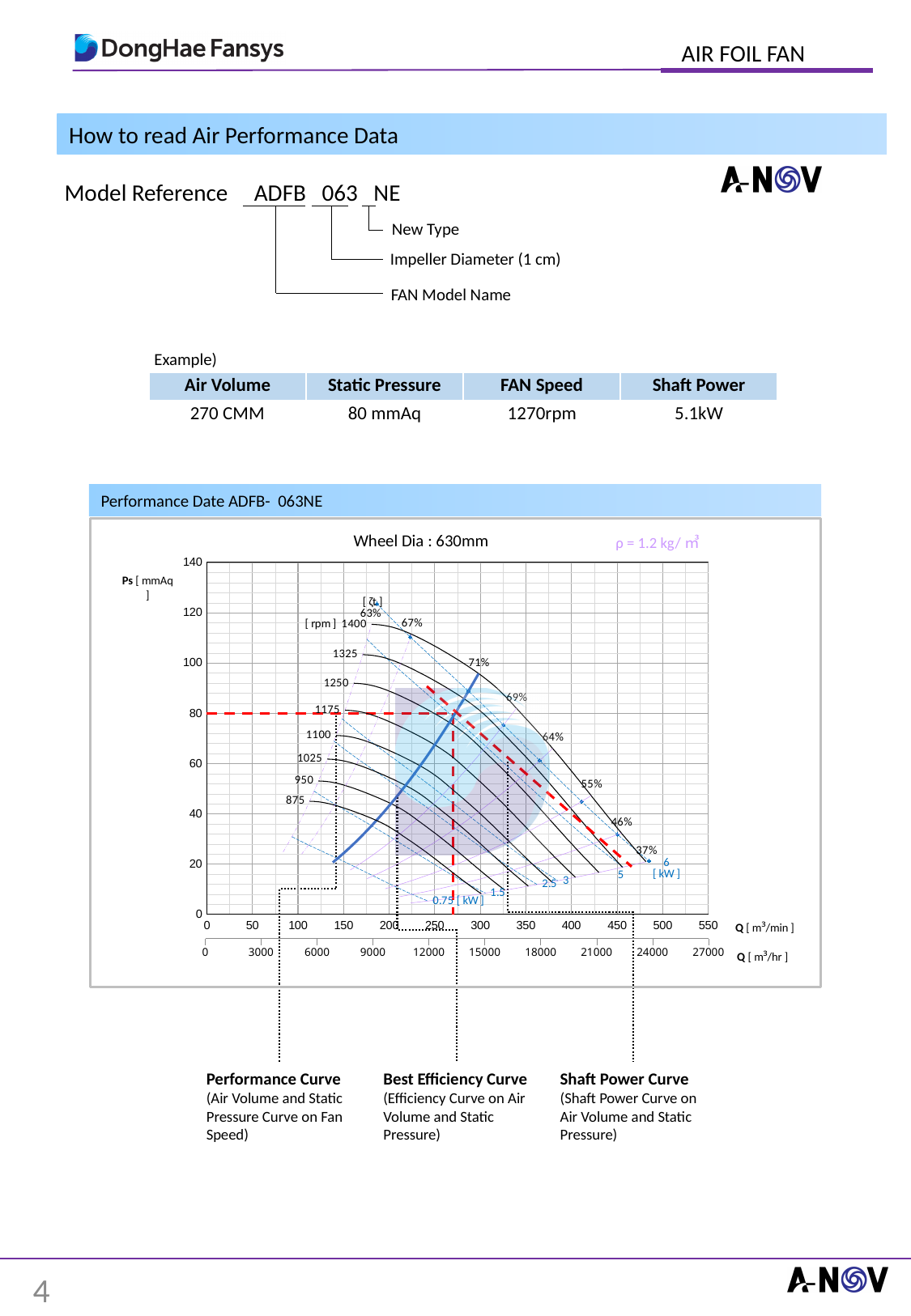
What is the lowest fan speed (rpm) labelled on the performance curves? 875 What kind of chart is shown under "Performance Date ADFB-063NE"? line chart What wheel diameter is stated above the chart? 630mm What is the highest efficiency value labelled on the chart? 71% What is the highest shaft power value labelled on the chart? 6 What is the lowest shaft power value labelled on the chart? 0.75 What is the lowest efficiency value labelled on the chart? 37% Which is larger, the 1400 rpm curve label or the 875 rpm curve label? 1400 What is the highest fan speed (rpm) labelled on the performance curves? 1400 How many fan speed (rpm) curves are labelled on the chart? 8 What is the maximum value shown on the Ps [mmAq] axis? 140 At what static pressure (mmAq) is the horizontal red dashed line drawn on the chart? 80